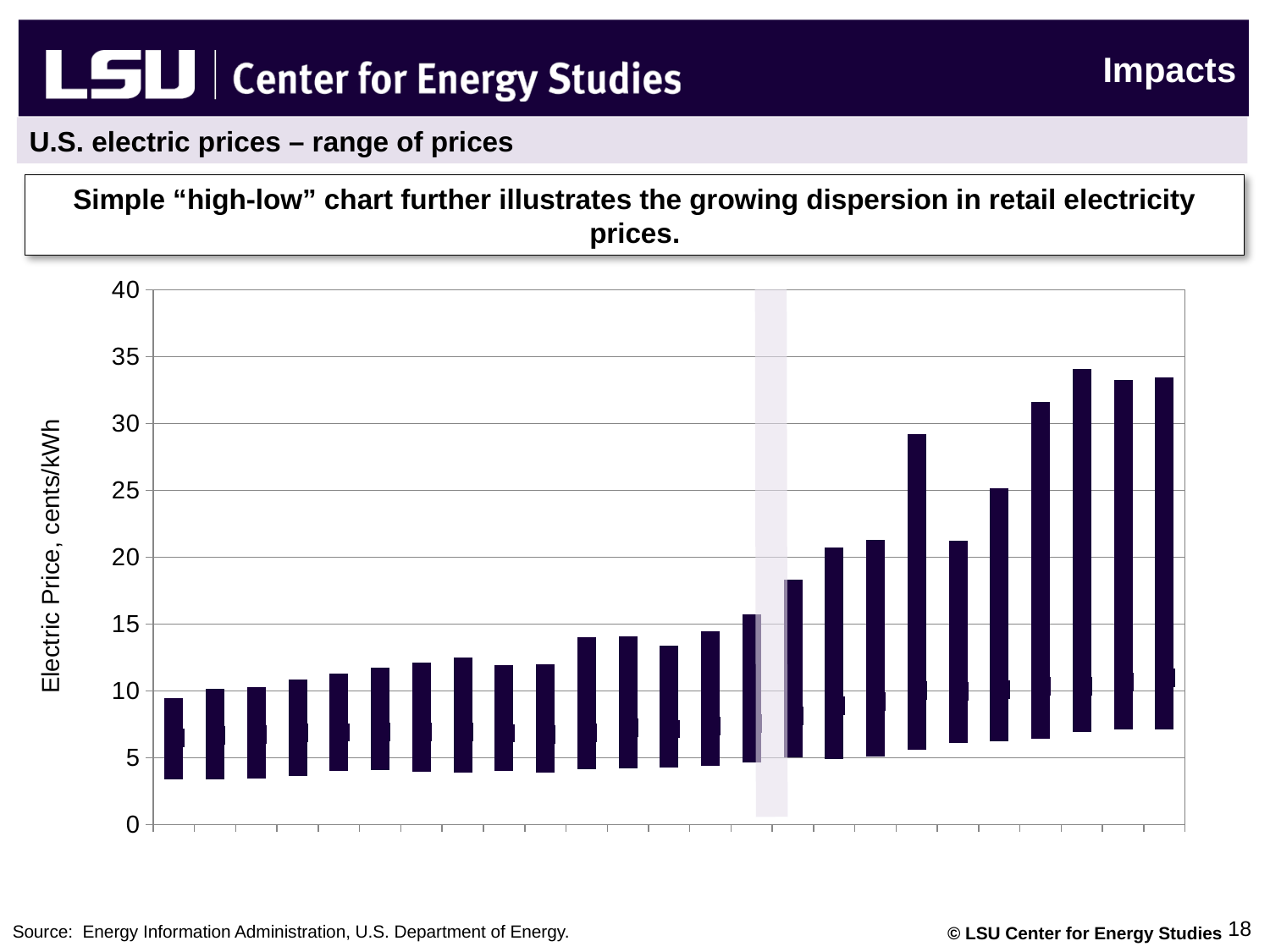
How many bars (price ranges) are plotted in the chart? 25 What is the maximum value shown on the vertical axis of the chart? 40 Which bar reaches a higher top value, the leftmost bar or the rightmost bar? the rightmost bar Is the bottom of the leftmost bar greater or less than 5 cents/kWh? less Do the tops of the bars generally rise or fall moving from left to right along the x axis? rise Is the top of the rightmost bar greater or less than 30 cents/kWh? greater Is the bottom of the rightmost bar greater or less than 5 cents/kWh? greater How many bars have tops above 30 cents/kWh? 4 What kind of chart is shown on the slide? bar chart (high-low range chart) What is the label of the vertical axis of the chart? Electric Price, cents/kWh